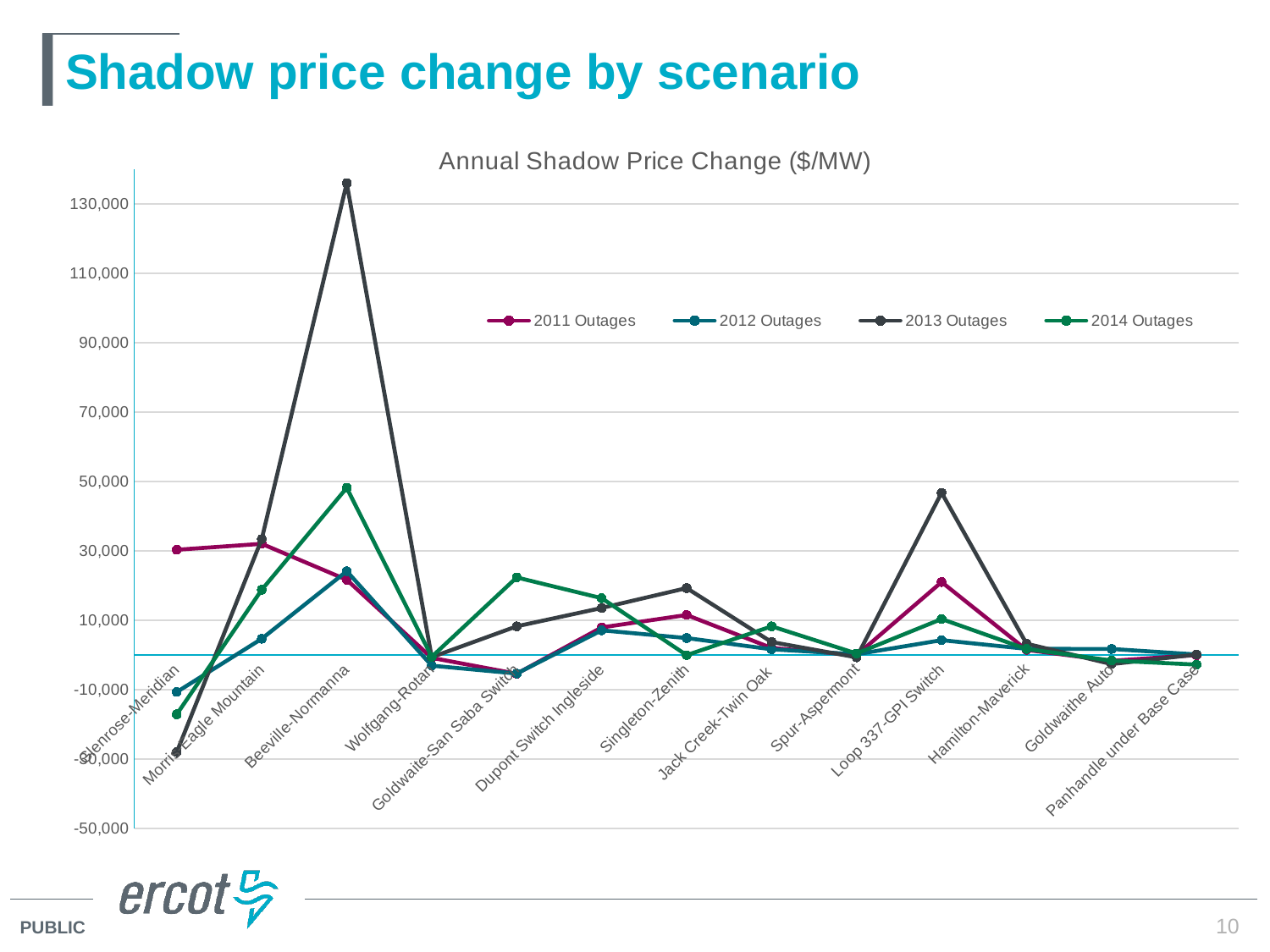
Is the 2013 Outages value for Beeville-Normanna greater or less than 130,000? greater Which category has the highest value for the 2014 Outages series? Beeville-Normanna Is the 2014 Outages value for Beeville-Normanna greater or less than 50,000? less Is the 2011 Outages value for Loop 337-GPI Switch greater or less than 10,000? greater At Beeville-Normanna, which series has the larger value: 2013 Outages or 2014 Outages? 2013 Outages How many categories are plotted along the x axis? 13 What kind of chart is shown on the slide? Line chart How many series does the legend list? 4 Which category has the highest value for the 2013 Outages series? Beeville-Normanna Which category has the lowest value for the 2014 Outages series? Glenrose-Meridian Which category has the lowest value for the 2013 Outages series? Glenrose-Meridian What is the title of the chart? Annual Shadow Price Change ($/MW)